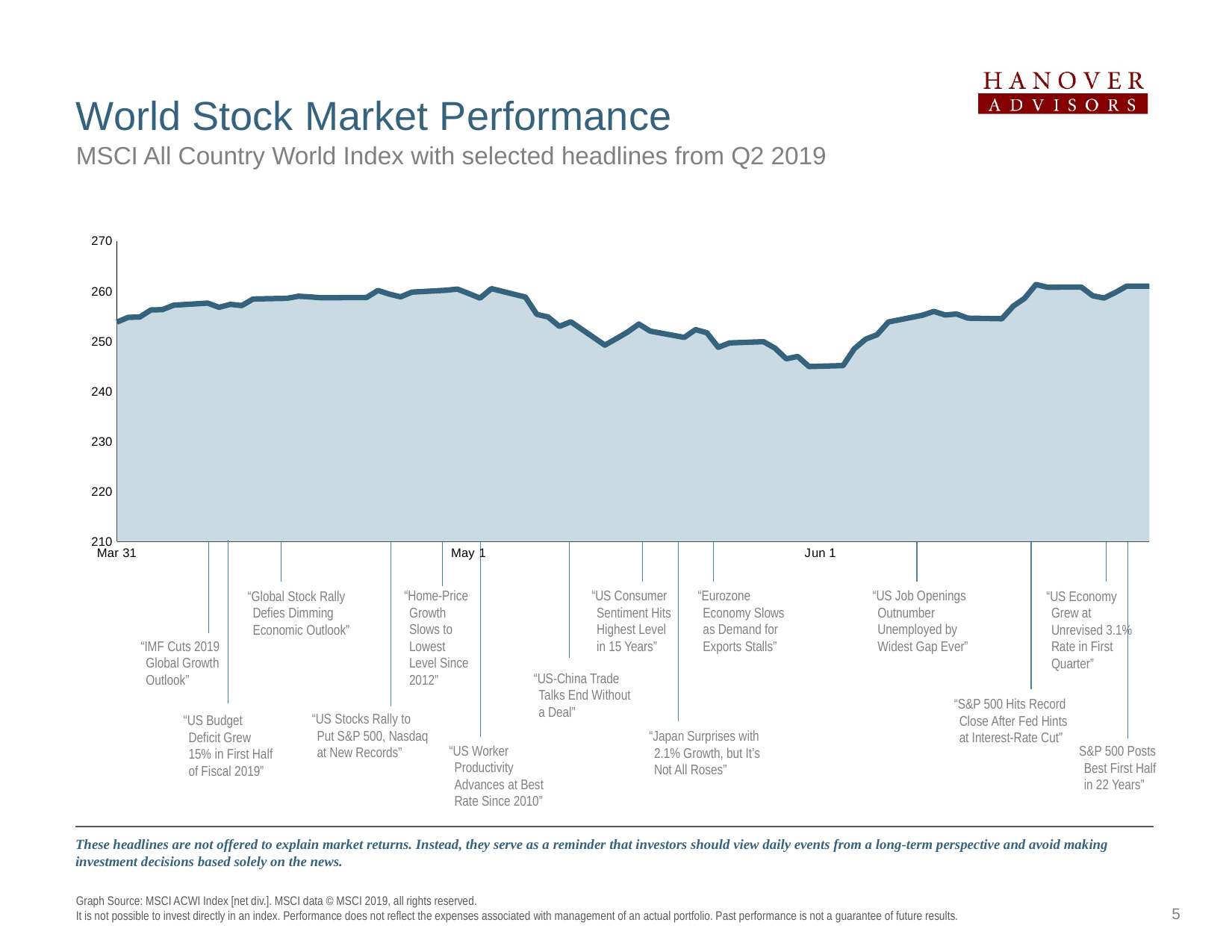
What kind of chart is shown on the slide? Area chart Which is higher, the index value at Mar 31 or the index value at Jun 1? Mar 31 What is the title of the slide's chart? World Stock Market Performance Is the index value at Jun 1 greater or less than 250? less Is the index value at Mar 31 greater or less than 250? greater What is the lowest value shown on the vertical axis? 210 Does the index rise or fall between May 1 and Jun 1? fall Around which labelled date does the index reach its lowest point: Mar 31, May 1 or Jun 1? Jun 1 Is the index value at May 1 greater or less than 250? greater Does the index rise or fall between Jun 1 and the end of June? rise Which index does the chart plot, according to the subtitle? MSCI All Country World Index